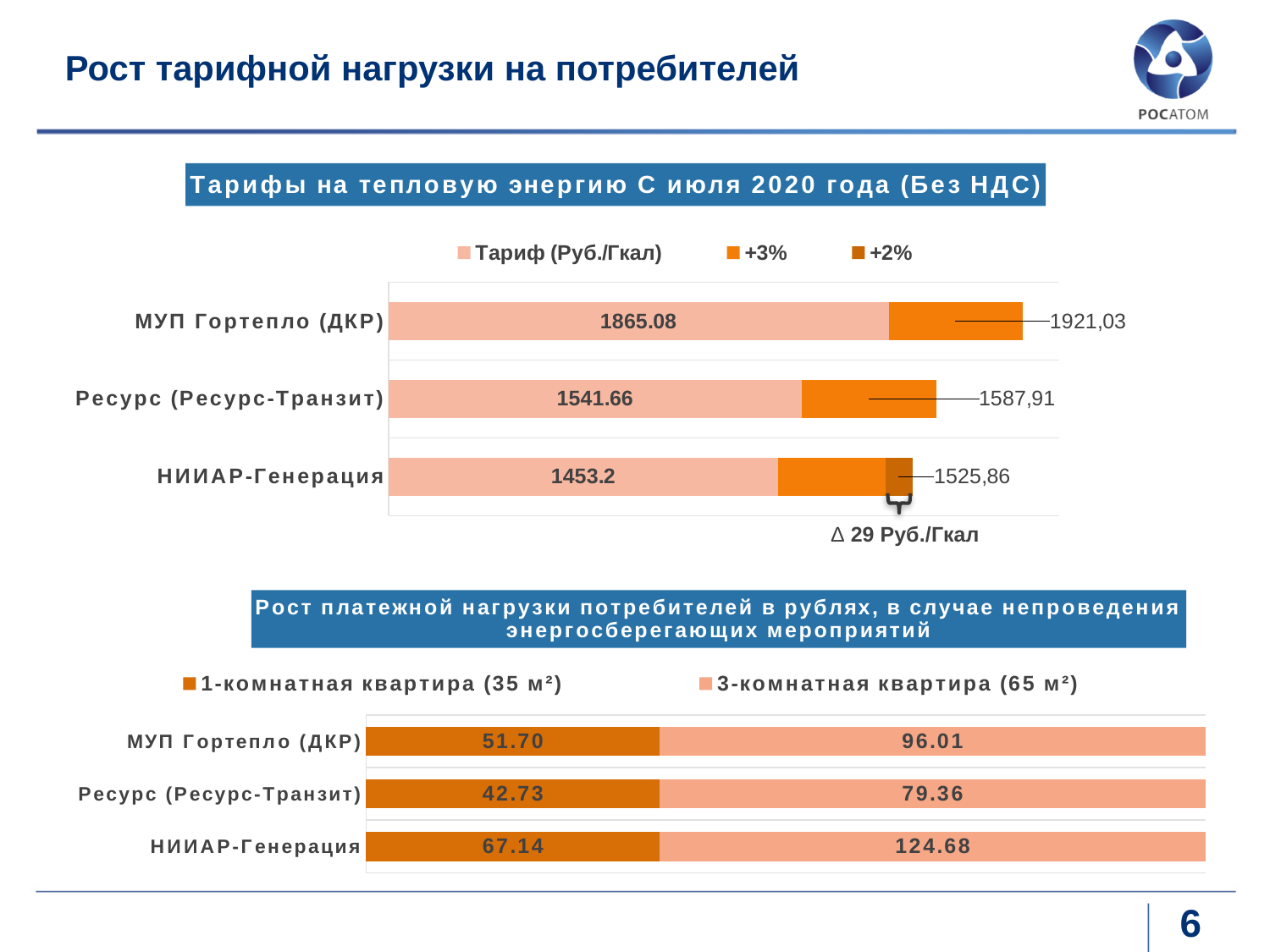
In the top chart (Тарифы на тепловую энергию), what is the Тариф (Руб./Гкал) value for НИИАР-Генерация? 1453.2 In the bottom chart (Рост платежной нагрузки потребителей), which category has the lowest value for 1-комнатная квартира (35 м²)? Ресурс (Ресурс-Транзит) In the top chart (Тарифы на тепловую энергию), what is the Тариф (Руб./Гкал) value for МУП Гортепло (ДКР)? 1865.08 In the bottom chart (Рост платежной нагрузки потребителей), what is the total of the stacked bar for МУП Гортепло (ДКР)? 147.71 In the top chart (Тарифы на тепловую энергию), what total value is shown at the end of the bar for Ресурс (Ресурс-Транзит)? 1587,91 In the top chart (Тарифы на тепловую энергию), which category has the highest Тариф (Руб./Гкал) value? МУП Гортепло (ДКР) In the bottom chart (Рост платежной нагрузки потребителей), which is larger: the 3-комнатная квартира (65 м²) value for МУП Гортепло (ДКР) or for Ресурс (Ресурс-Транзит)? МУП Гортепло (ДКР) In the bottom chart (Рост платежной нагрузки потребителей), what is the value for 1-комнатная квартира (35 м²) for Ресурс (Ресурс-Транзит)? 42.73 How many series does the legend of the top chart (Тарифы на тепловую энергию) list? 3 What type of chart is the bottom chart (Рост платежной нагрузки потребителей)? Bar chart In the top chart (Тарифы на тепловую энергию), what is the difference between the Тариф (Руб./Гкал) values for МУП Гортепло (ДКР) and Ресурс (Ресурс-Транзит)? 323.42 In the bottom chart (Рост платежной нагрузки потребителей), what is the value for 3-комнатная квартира (65 м²) for НИИАР-Генерация? 124.68